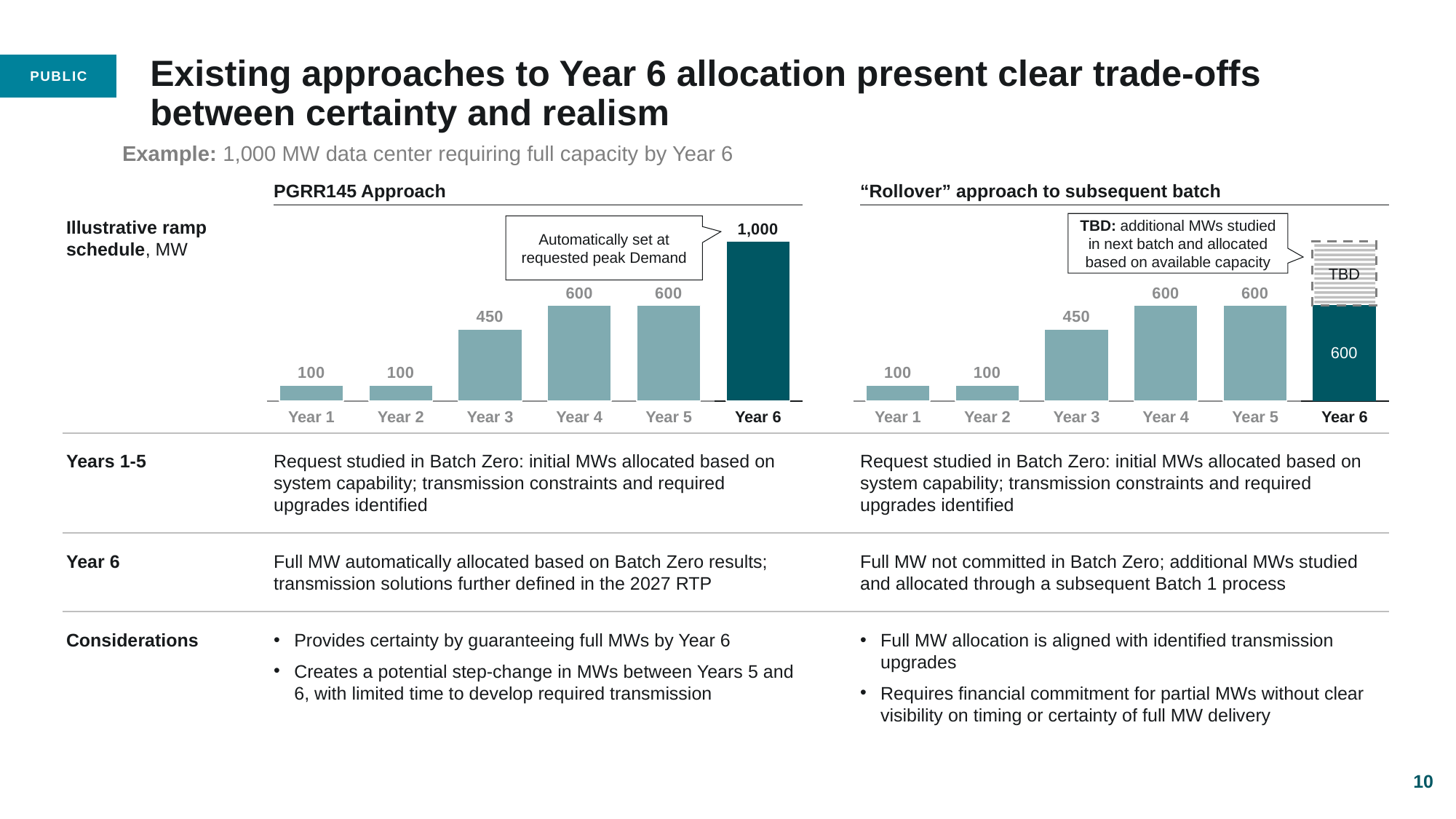
How many years are shown on the x axis of the PGRR145 Approach chart? 6 In the "Rollover" approach chart, what is the difference between the Year 3 and Year 2 values? 350 In the PGRR145 Approach chart, what is the value for Year 6? 1,000 What unit is given for the illustrative ramp schedule charts? MW In the PGRR145 Approach chart, do the values generally rise or fall from Year 1 to Year 6? Rise In the PGRR145 Approach chart, what is the difference between the Year 6 and Year 5 values? 400 In the "Rollover" approach chart, what is the committed value shown for Year 6? 600 In the PGRR145 Approach chart, which is larger, the value for Year 4 or the value for Year 2? Year 4 In the "Rollover" approach chart, what label is shown on the hatched portion above the Year 6 bar? TBD In the PGRR145 Approach chart, which year has the highest value? Year 6 In the PGRR145 Approach chart, what is the value for Year 3? 450 What kind of chart is the "Rollover" approach chart? Bar chart